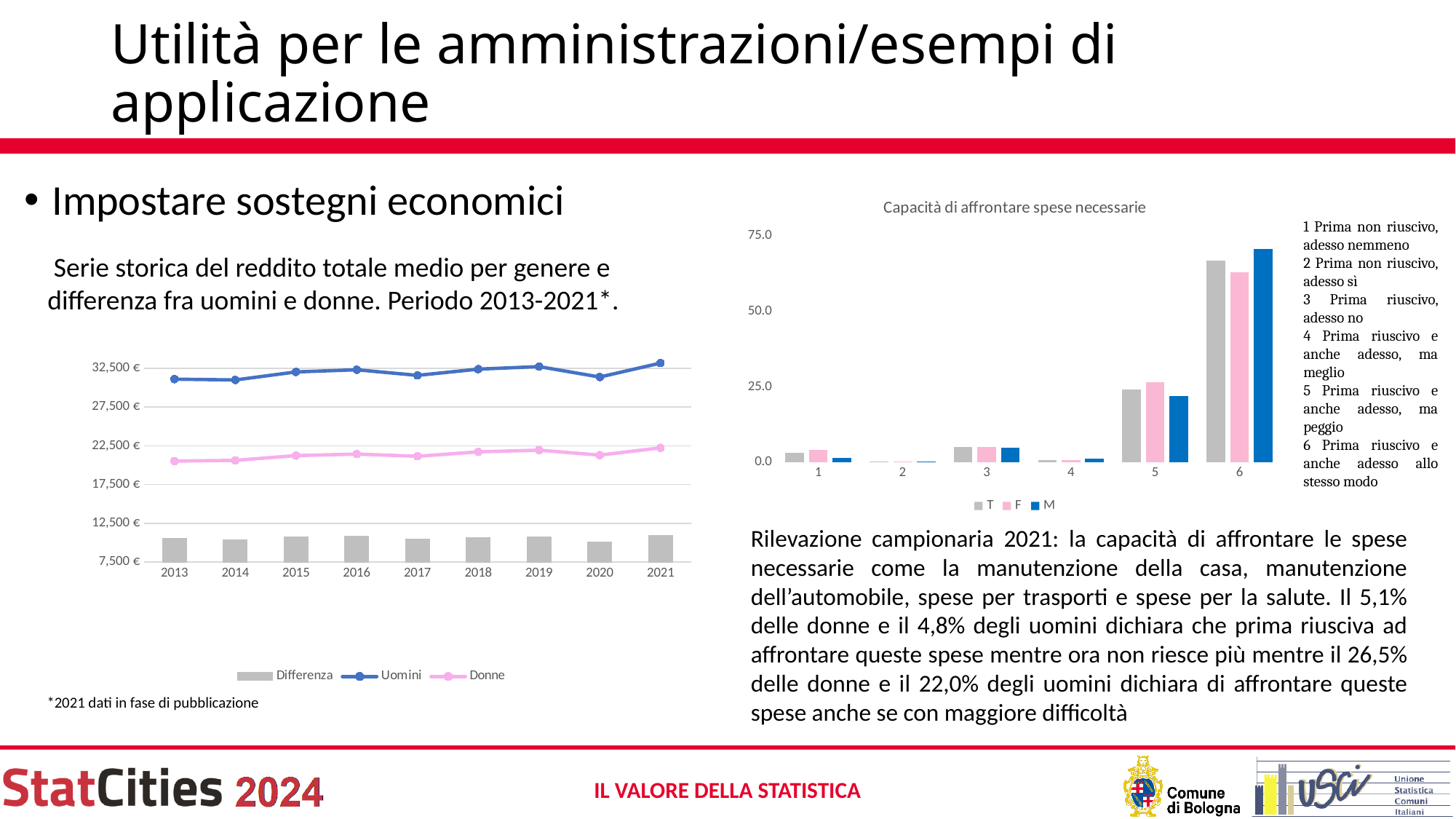
On the right chart (Capacità di affrontare spese necessarie), how many series does the legend list? 3 On the left chart (Serie storica del reddito totale medio per genere), how many series does the legend list? 3 On the left chart (Serie storica del reddito totale medio per genere), how many years are shown on the x axis? 9 On the right chart (Capacità di affrontare spese necessarie), which category has the highest values? 6 On the left chart (Serie storica del reddito totale medio per genere), is the Differenza value for 2016 greater or less than 12,500 €? less On the right chart (Capacità di affrontare spese necessarie), for category 6, which is larger, F or M? M On the left chart (Serie storica del reddito totale medio per genere), which series has higher values, Uomini or Donne? Uomini On the left chart (Serie storica del reddito totale medio per genere), is the Uomini value for 2013 greater or less than 32,500 €? less On the right chart (Capacità di affrontare spese necessarie), is the M value for category 6 greater or less than 50.0? greater On the left chart (Serie storica del reddito totale medio per genere), which series is plotted as bars? Differenza On the right chart (Capacità di affrontare spese necessarie), how many categories are shown on the x axis? 6